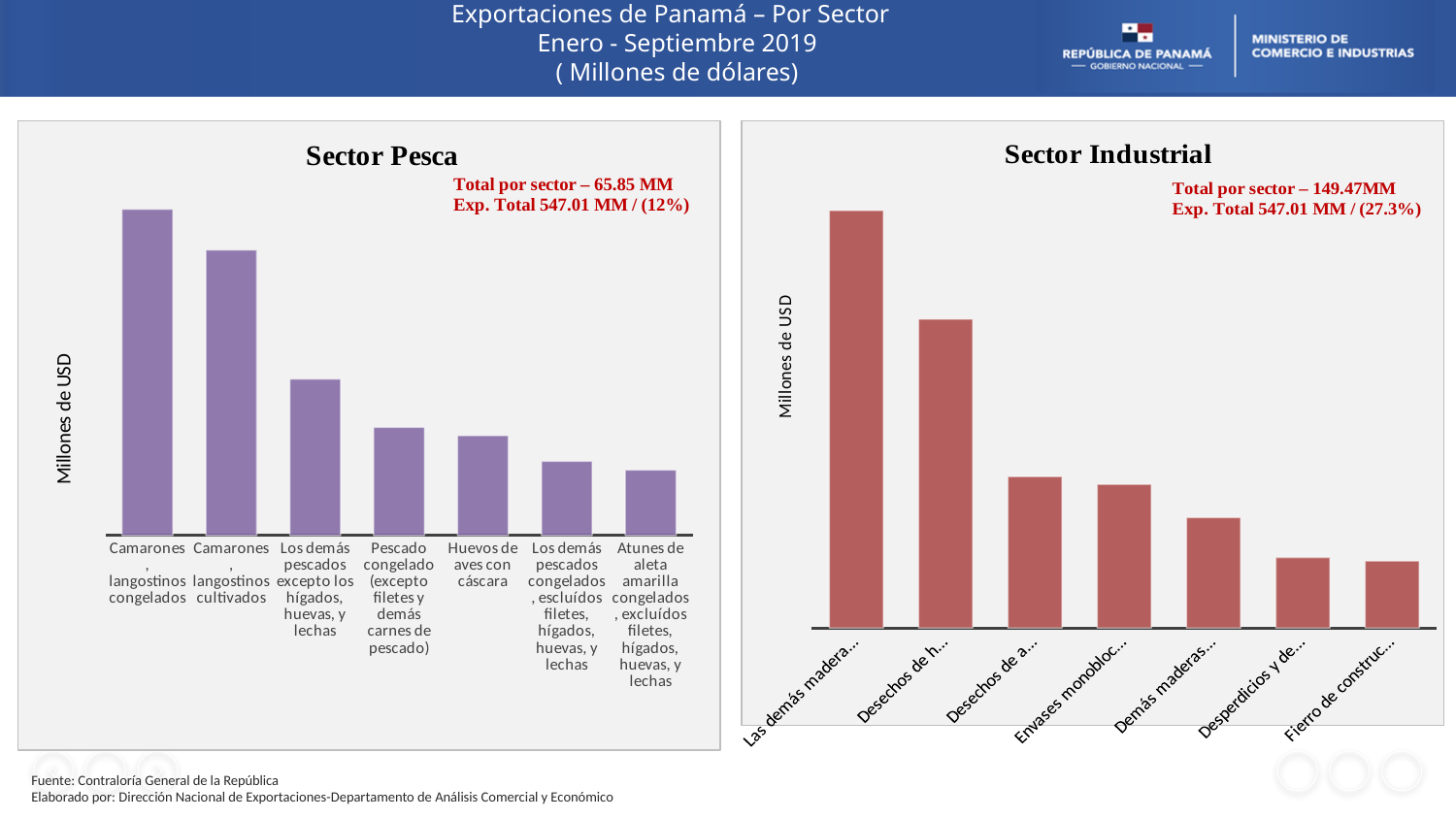
According to the annotation on the Sector Industrial chart, what percentage of total exports does the sector represent? 27.3% How many categories are shown in the Sector Pesca chart? 7 According to the annotation on the Sector Pesca chart, what is the total for the sector? 65.85 MM In the Sector Pesca chart, which category has the highest value? Camarones, langostinos congelados In the Sector Industrial chart, which is larger: Envases monobloc... or Demás maderas...? Envases monobloc... What kind of chart is the Sector Pesca chart? bar chart In the Sector Industrial chart, which category has the highest value? Las demás madera... In the Sector Industrial chart, do the bar values rise or fall from left to right? fall In the Sector Industrial chart, which is larger: Desechos de h... or Desechos de a...? Desechos de h... In the Sector Pesca chart, which is larger: Los demás pescados excepto los hígados, huevas, y lechas or Pescado congelado (excepto filetes y demás carnes de pescado)? Los demás pescados excepto los hígados, huevas, y lechas How many bars are shown in the Sector Industrial chart? 7